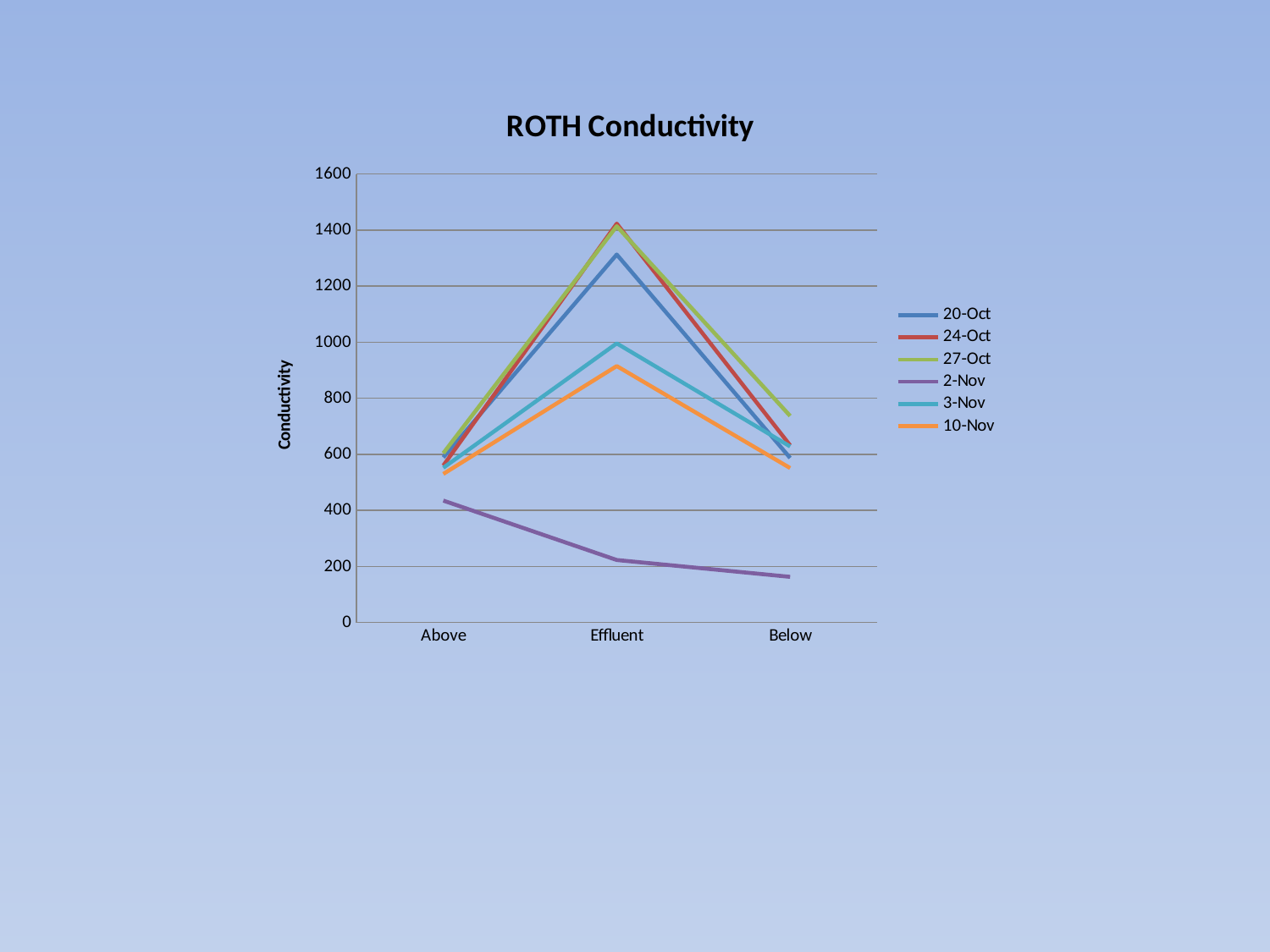
At Effluent, which is larger: the value for 20-Oct or the value for 3-Nov? 20-Oct Is the value for 2-Nov at Above greater or less than 400? greater What is the label on the vertical axis? Conductivity Does the 2-Nov line rise or fall from Above to Below? fall Is the value for 20-Oct at Effluent greater or less than 1200? greater What is the title of the chart? ROTH Conductivity How many categories are shown on the x axis? 3 Which series has the lowest value at Effluent? 2-Nov Is the value for 2-Nov at Below greater or less than 200? less What kind of chart is shown on the slide? line chart How many series does the legend list? 6